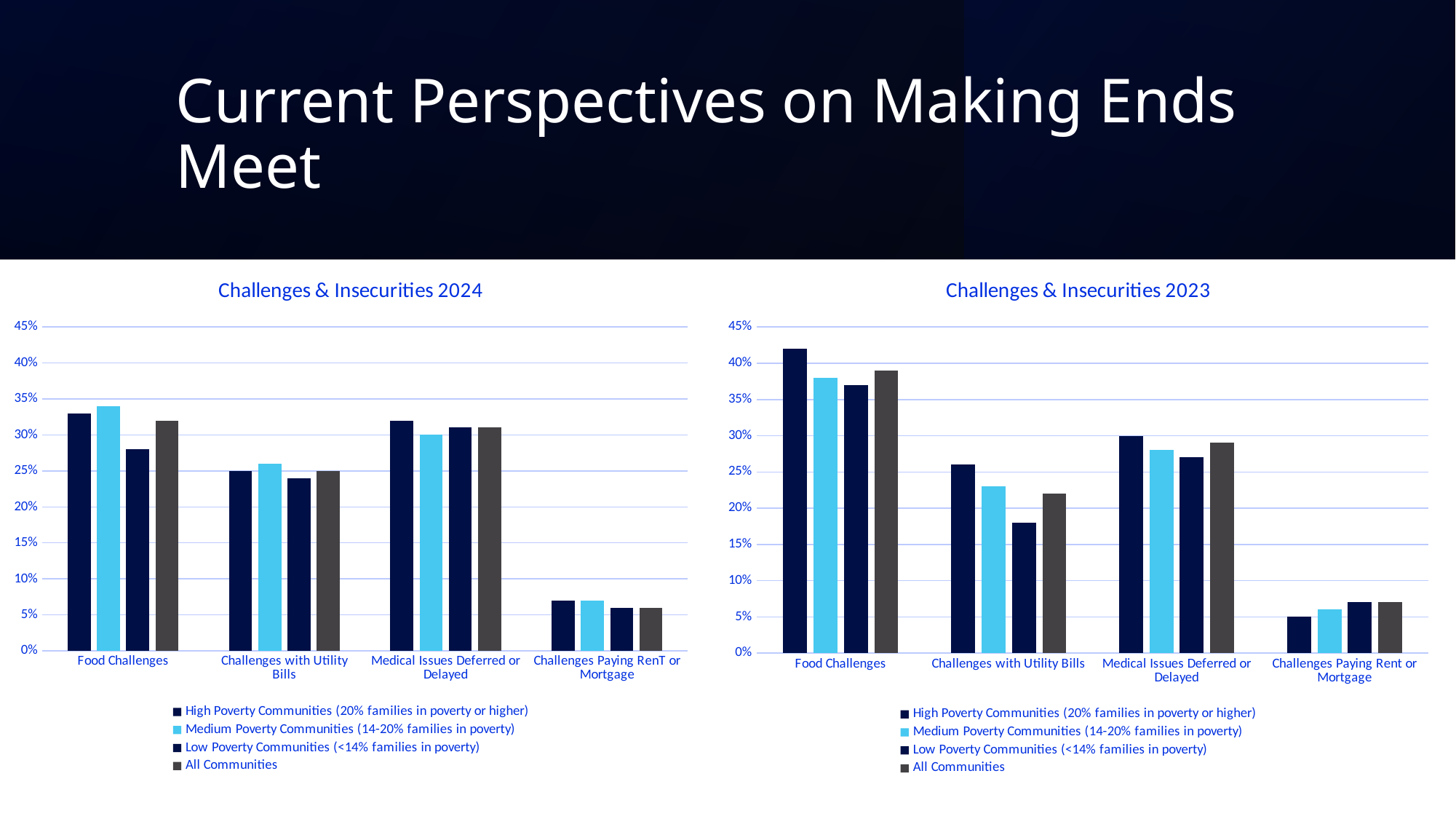
In 'Challenges & Insecurities 2023', which series has the lowest bar for Challenges with Utility Bills? Low Poverty Communities (<14% families in poverty) What is the title of the chart on the left side of the slide? Challenges & Insecurities 2024 In 'Challenges & Insecurities 2023', which series has the highest bar for Food Challenges? High Poverty Communities (20% families in poverty or higher) In 'Challenges & Insecurities 2023', which is larger for Food Challenges: High Poverty Communities or Medium Poverty Communities? High Poverty Communities How many categories are shown on the x axis of 'Challenges & Insecurities 2024'? 4 In 'Challenges & Insecurities 2024', which category has the lowest value for All Communities? Challenges Paying RenT or Mortgage In 'Challenges & Insecurities 2023', is the value for Medium Poverty Communities on Medical Issues Deferred or Delayed greater or less than 30%? less How many series does the legend of 'Challenges & Insecurities 2023' list? 4 In 'Challenges & Insecurities 2024', is the value for High Poverty Communities on Food Challenges greater or less than 30%? greater What type of chart is 'Challenges & Insecurities 2024'? Bar chart In 'Challenges & Insecurities 2023', is the value for All Communities on Challenges Paying Rent or Mortgage greater or less than 10%? less In 'Challenges & Insecurities 2024', which is larger for Challenges with Utility Bills: Medium Poverty Communities or Low Poverty Communities? Medium Poverty Communities